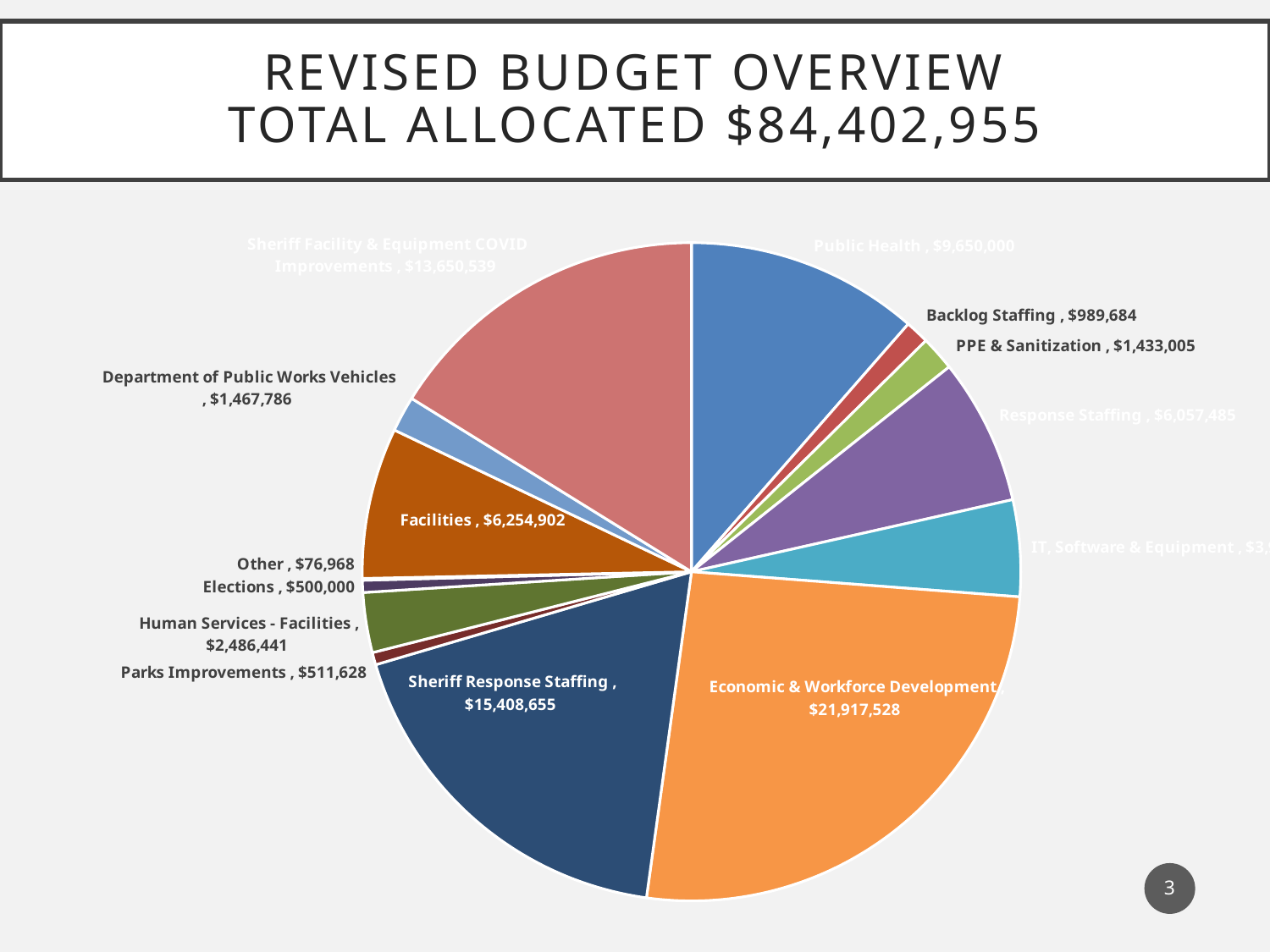
Which category has the smallest slice of the pie? Other What is the difference between Elections and Other? $423,032 What total allocated amount is stated in the slide title? $84,402,955 What type of chart is shown on the slide? Pie chart What is the value for Department of Public Works Vehicles? $1,467,786 What is the value for Facilities? $6,254,902 What is the difference between Economic & Workforce Development and Sheriff Response Staffing? $6,508,873 What is the value for Human Services - Facilities? $2,486,441 What is the value for Economic & Workforce Development? $21,917,528 Which category has the largest slice of the pie? Economic & Workforce Development What is the value for Sheriff Response Staffing? $15,408,655 Which is larger, Backlog Staffing or PPE & Sanitization? PPE & Sanitization